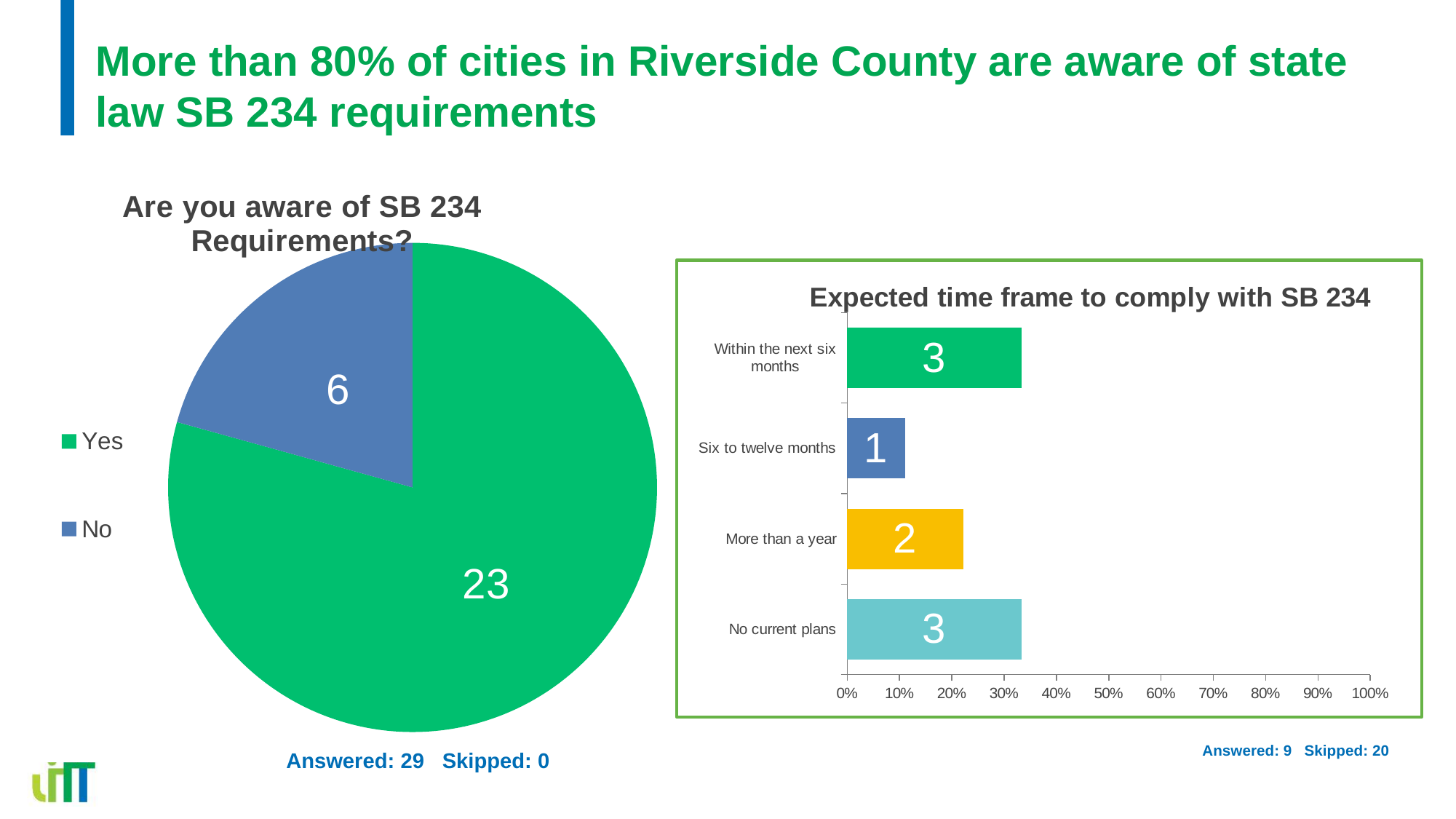
What kind of chart is 'Expected time frame to comply with SB 234'? Bar chart In the chart 'Expected time frame to comply with SB 234', is the bar for 'Six to twelve months' greater or less than 20%? less In the pie chart 'Are you aware of SB 234 Requirements?', what is the value for Yes? 23 How many categories are shown in the chart 'Expected time frame to comply with SB 234'? 4 In the chart 'Expected time frame to comply with SB 234', what is the value for 'Six to twelve months'? 1 In the chart 'Expected time frame to comply with SB 234', which category has the lowest value? Six to twelve months In the pie chart 'Are you aware of SB 234 Requirements?', which slice is larger, Yes or No? Yes In the chart 'Expected time frame to comply with SB 234', what is the difference between the values for 'Within the next six months' and 'More than a year'? 1 In the pie chart 'Are you aware of SB 234 Requirements?', what is the value for No? 6 In the pie chart 'Are you aware of SB 234 Requirements?', what is the difference between the Yes and No values? 17 In the chart 'Expected time frame to comply with SB 234', what is the value for 'More than a year'? 2 How many entries does the legend of the pie chart 'Are you aware of SB 234 Requirements?' list? 2